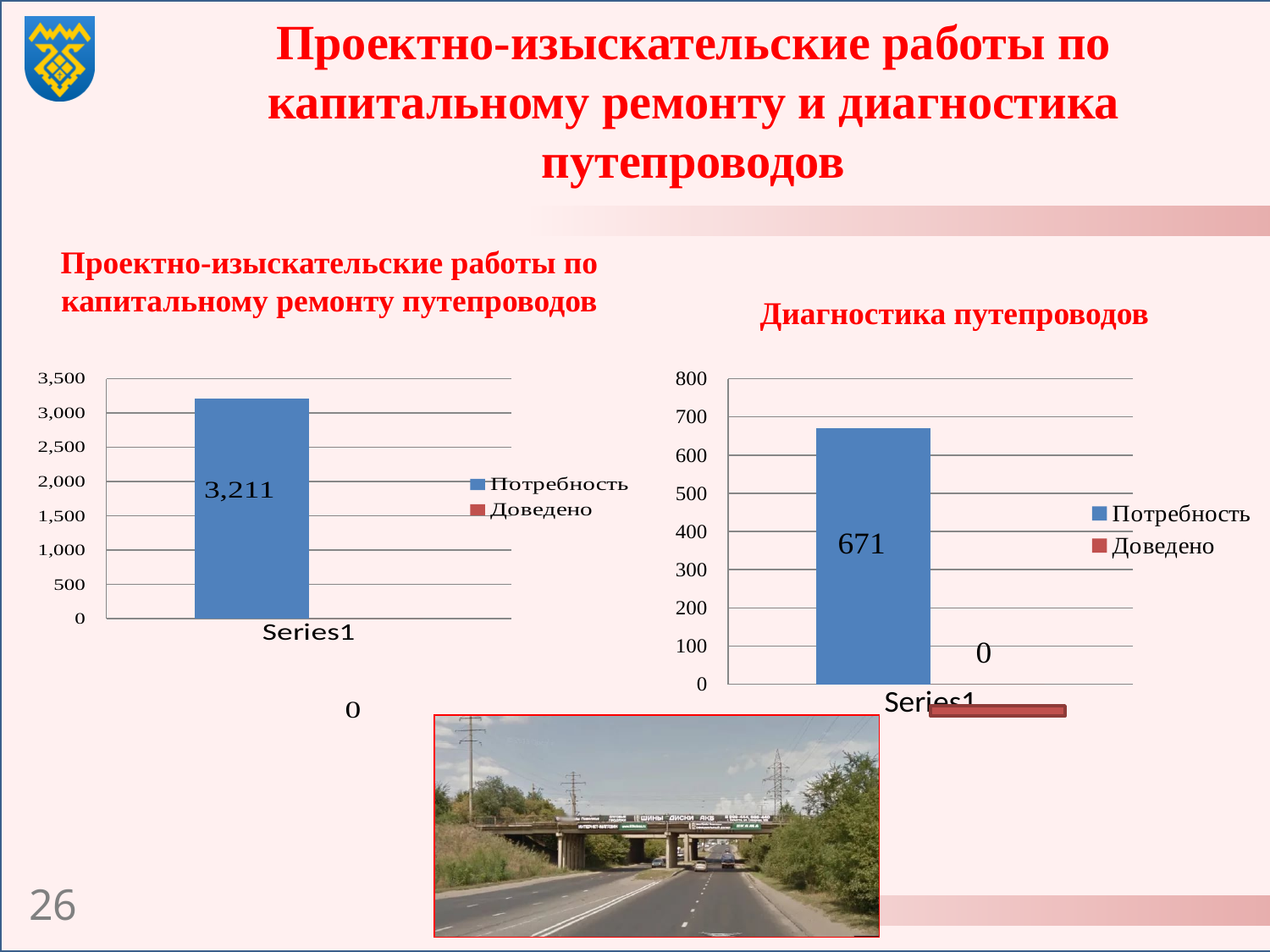
In the chart titled "Проектно-изыскательские работы по капитальному ремонту путепроводов", what is the value for Доведено? 0 In the chart titled "Проектно-изыскательские работы по капитальному ремонту путепроводов", what is the difference between Потребность and Доведено? 3,211 How many series does the legend list in the chart titled "Диагностика путепроводов"? 2 In the chart titled "Диагностика путепроводов", what is the value for Потребность? 671 In the chart titled "Диагностика путепроводов", is the value for Потребность greater or less than 600? greater What kind of chart is the chart titled "Проектно-изыскательские работы по капитальному ремонту путепроводов"? bar chart In the chart titled "Диагностика путепроводов", what is the value for Доведено? 0 In the chart titled "Диагностика путепроводов", which series has the higher value, Потребность or Доведено? Потребность In the chart titled "Диагностика путепроводов", what colour is the bar for Потребность? blue In the chart titled "Проектно-изыскательские работы по капитальному ремонту путепроводов", what is the value for Потребность? 3,211 In the chart titled "Диагностика путепроводов", what is the difference between Потребность and Доведено? 671 In the chart titled "Проектно-изыскательские работы по капитальному ремонту путепроводов", is the value for Потребность greater or less than 3,000? greater